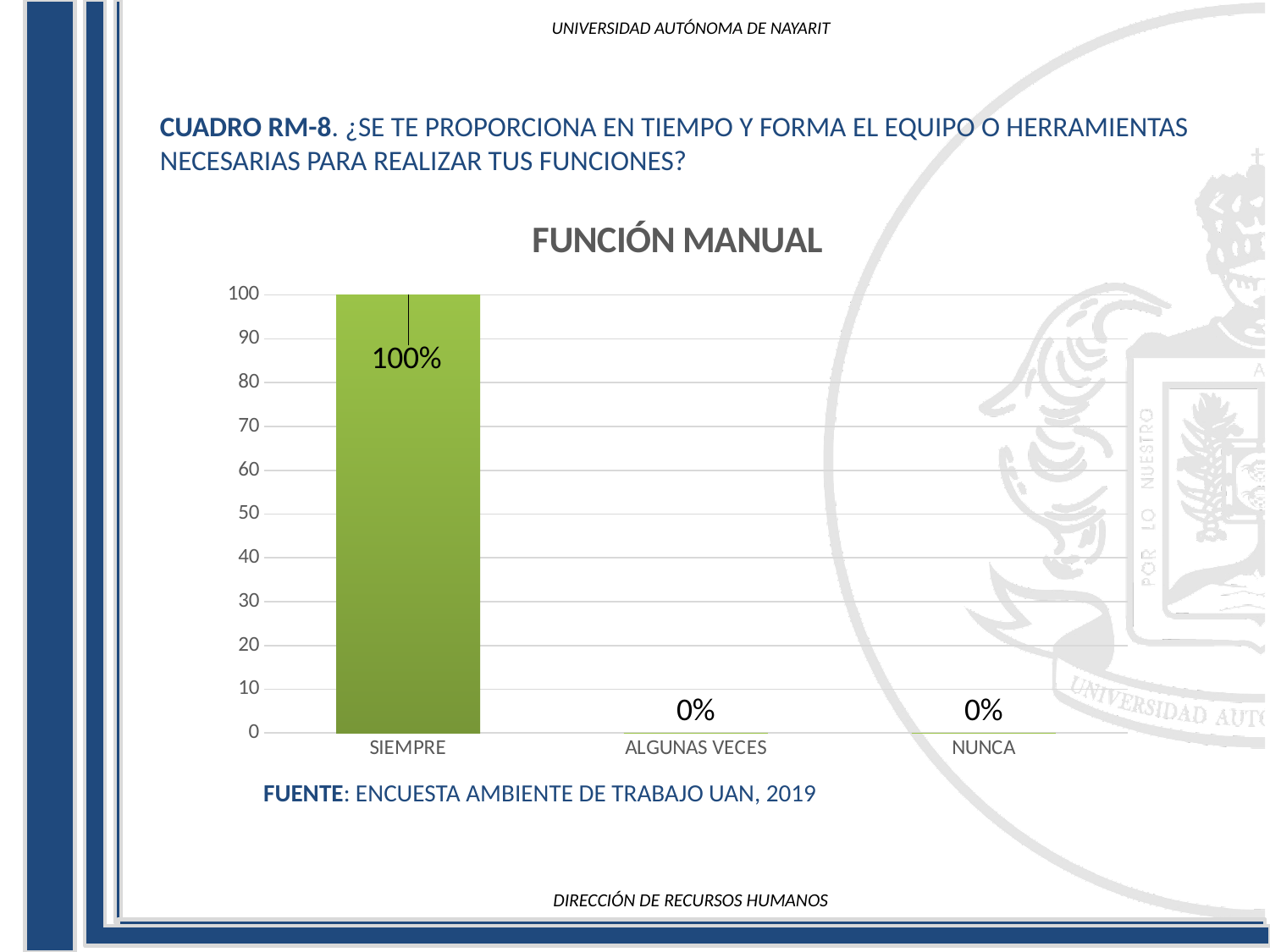
What is the value for SIEMPRE? 100% How many categories are shown on the x axis? 3 What is the title of the chart? FUNCIÓN MANUAL Which is larger, the value for SIEMPRE or the value for ALGUNAS VECES? SIEMPRE What is the difference between the values for SIEMPRE and NUNCA? 100% What is the value for ALGUNAS VECES? 0% What is the highest value shown on the y axis? 100 What kind of chart is shown? bar chart Is the value for SIEMPRE greater or less than 50? greater What is the source cited below the chart? ENCUESTA AMBIENTE DE TRABAJO UAN, 2019 What is the value for NUNCA? 0% Which category has the highest value? SIEMPRE